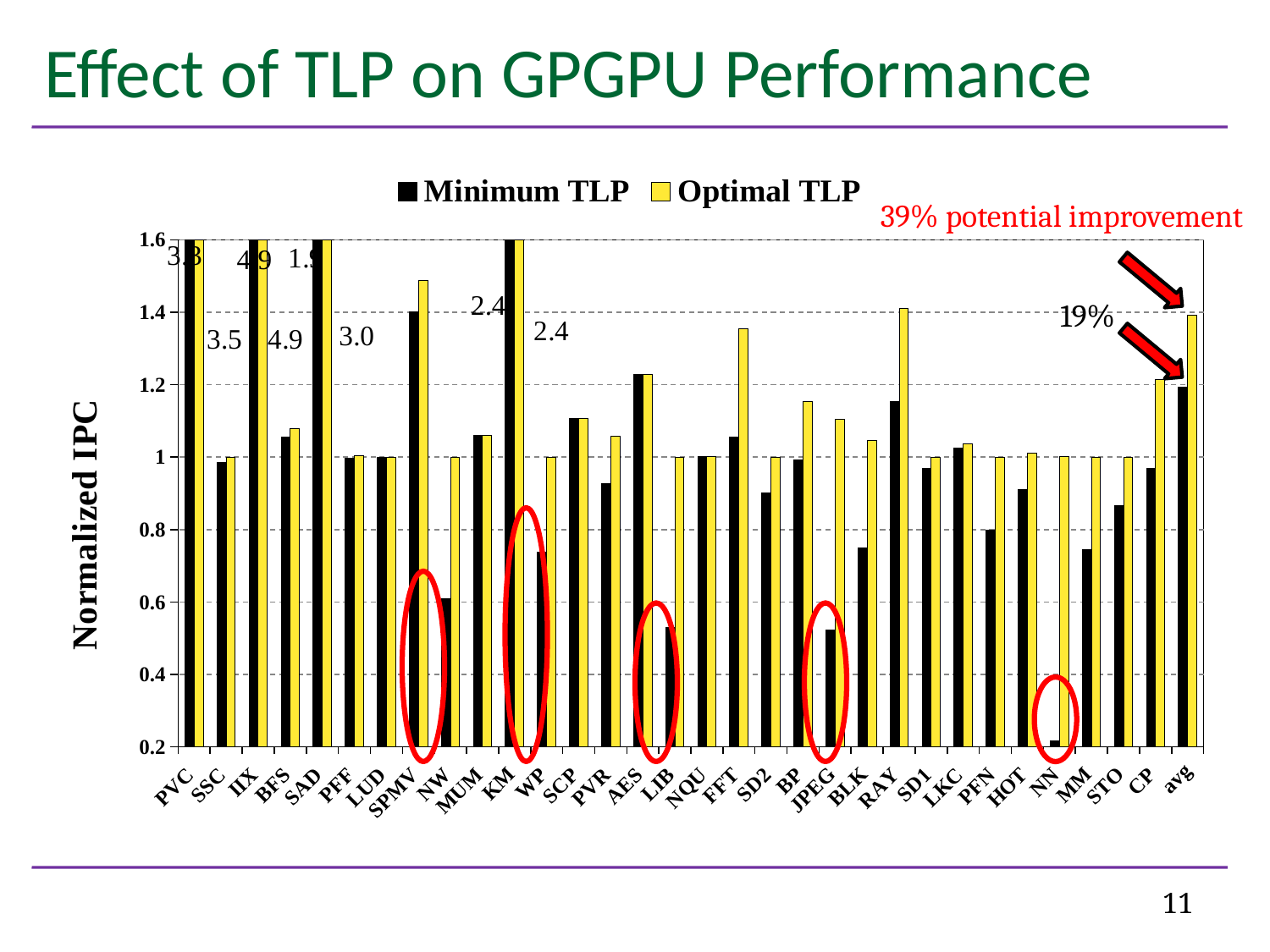
How many categories are shown along the x axis? 32 What value is printed for IIX? 4.9 Which category has the lowest Minimum TLP value? NN What potential improvement percentage is annotated at the top right of the chart? 39% What value is printed for KM? 2.4 Is the Minimum TLP value for JPEG greater or less than 0.6? less What kind of chart is shown on the slide? bar chart What is the label of the y axis? Normalized IPC For NN, which is larger: Minimum TLP or Optimal TLP? Optimal TLP Is the Optimal TLP value for RAY greater or less than 1.2? greater Which category has the highest Optimal TLP value? IIX How many series does the legend list? 2